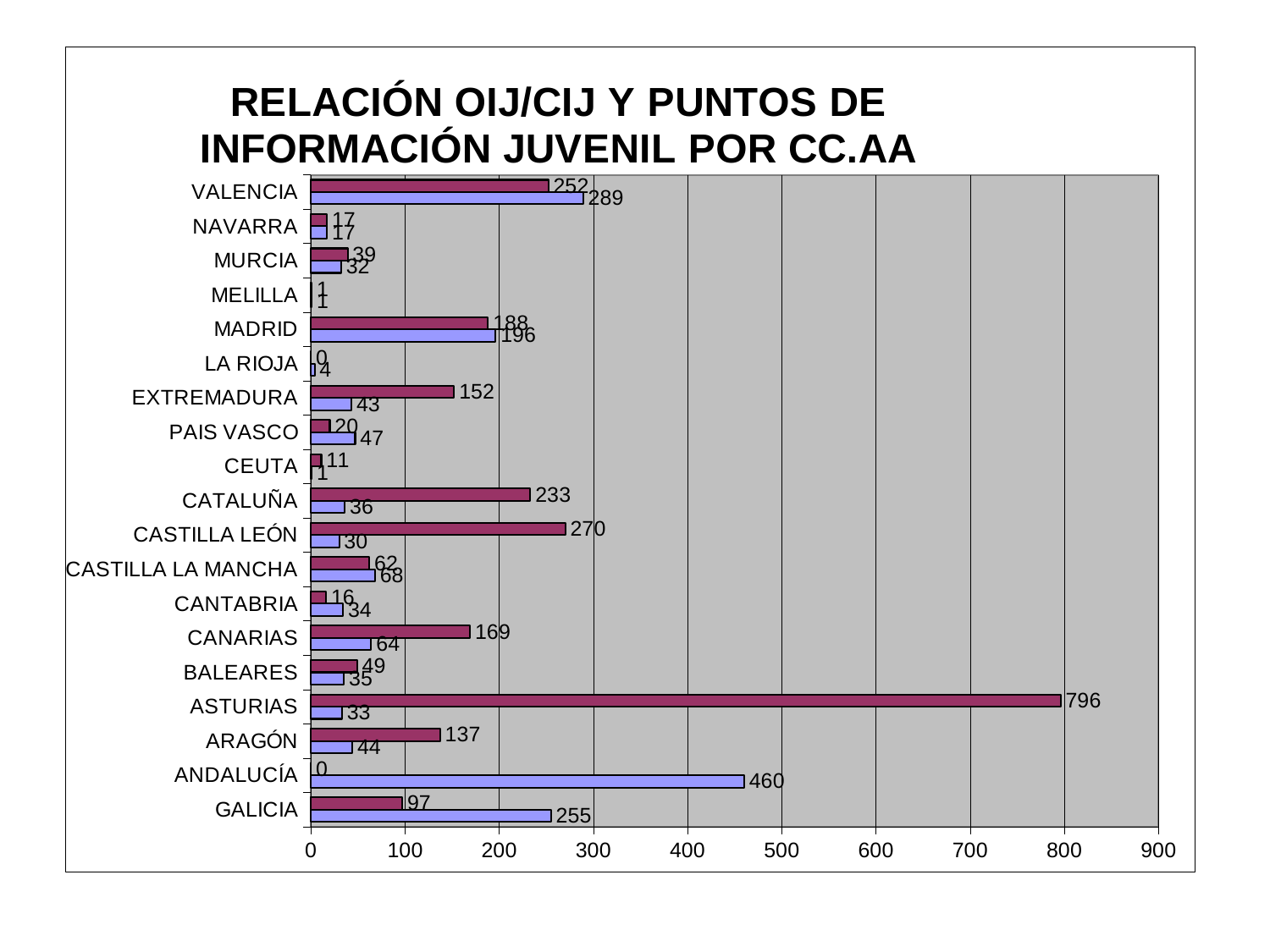
Which region has the highest light blue bar value? ANDALUCÍA What is the value of the light blue bar for ANDALUCÍA? 460 For EXTREMADURA, which bar is larger, the dark red one or the light blue one? dark red What is the title of the chart? RELACIÓN OIJ/CIJ Y PUNTOS DE INFORMACIÓN JUVENIL POR CC.AA What is the difference between the dark red bar (270) and the light blue bar (30) for CASTILLA LEÓN? 240 How many regions (categories) are shown on the chart? 19 Is the dark red bar value for ASTURIAS greater or less than 700? greater Which region has the highest dark red bar value? ASTURIAS What is the value of the light blue bar for GALICIA? 255 What is the value of the dark red bar for ASTURIAS? 796 What type of chart is shown on the slide? bar chart What is the difference between the light blue bar (289) and the dark red bar (252) for VALENCIA? 37